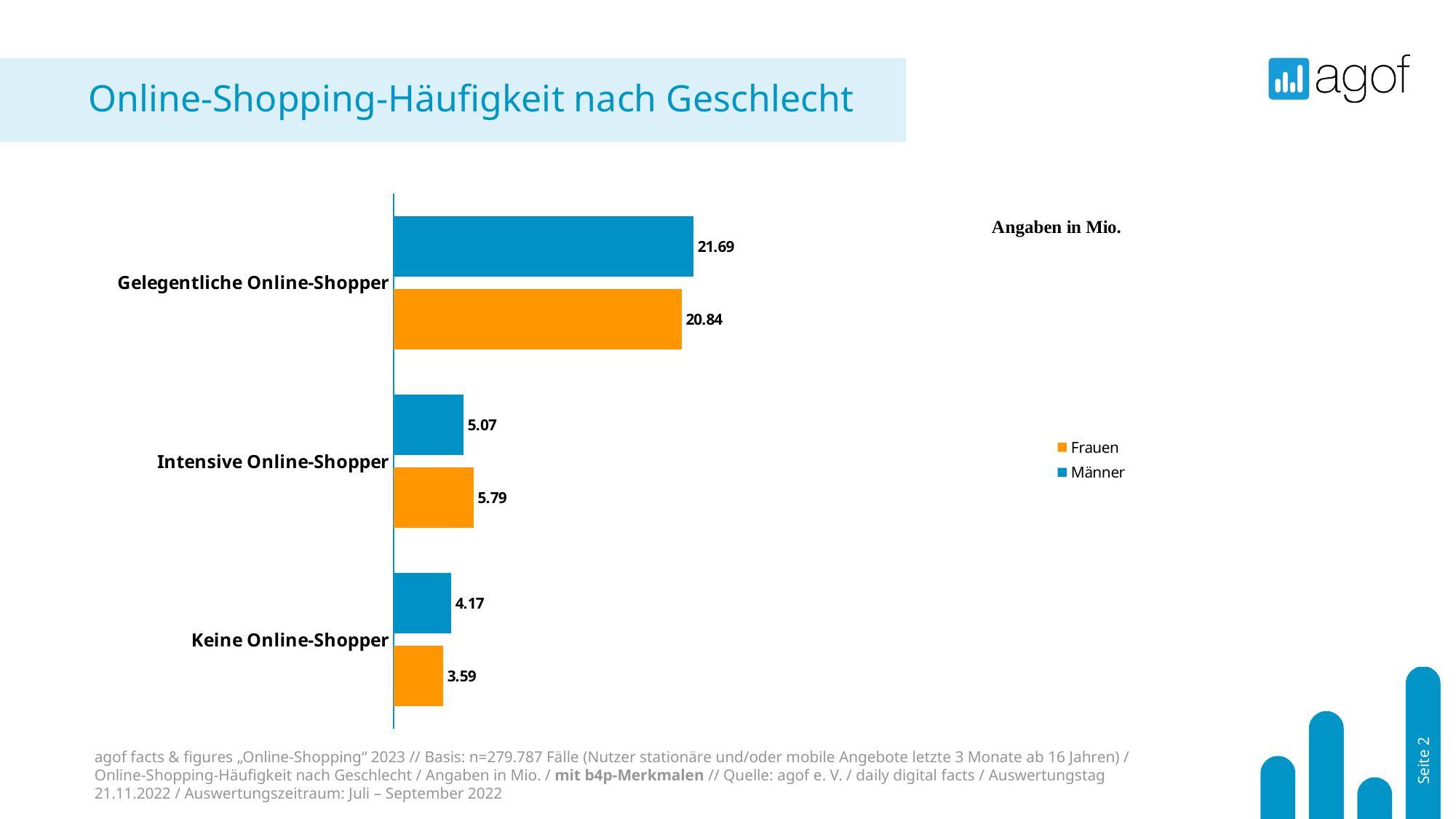
What is the difference between the Frauen and Männer values for Intensive Online-Shopper? 0.72 What is the value for Frauen in the Intensive Online-Shopper category? 5.79 Which category has the lowest value for Männer? Keine Online-Shopper How many categories are shown on the chart? 3 Which category has the highest value for Frauen? Gelegentliche Online-Shopper What is the value for Männer in the Keine Online-Shopper category? 4.17 How many series does the legend list? 2 What is the value for Männer in the Gelegentliche Online-Shopper category? 21.69 What kind of chart is shown on the slide? Bar chart What is the difference between the Männer and Frauen values for Gelegentliche Online-Shopper? 0.85 What is the value for Frauen in the Keine Online-Shopper category? 3.59 In the Intensive Online-Shopper category, which is larger: Frauen or Männer? Frauen